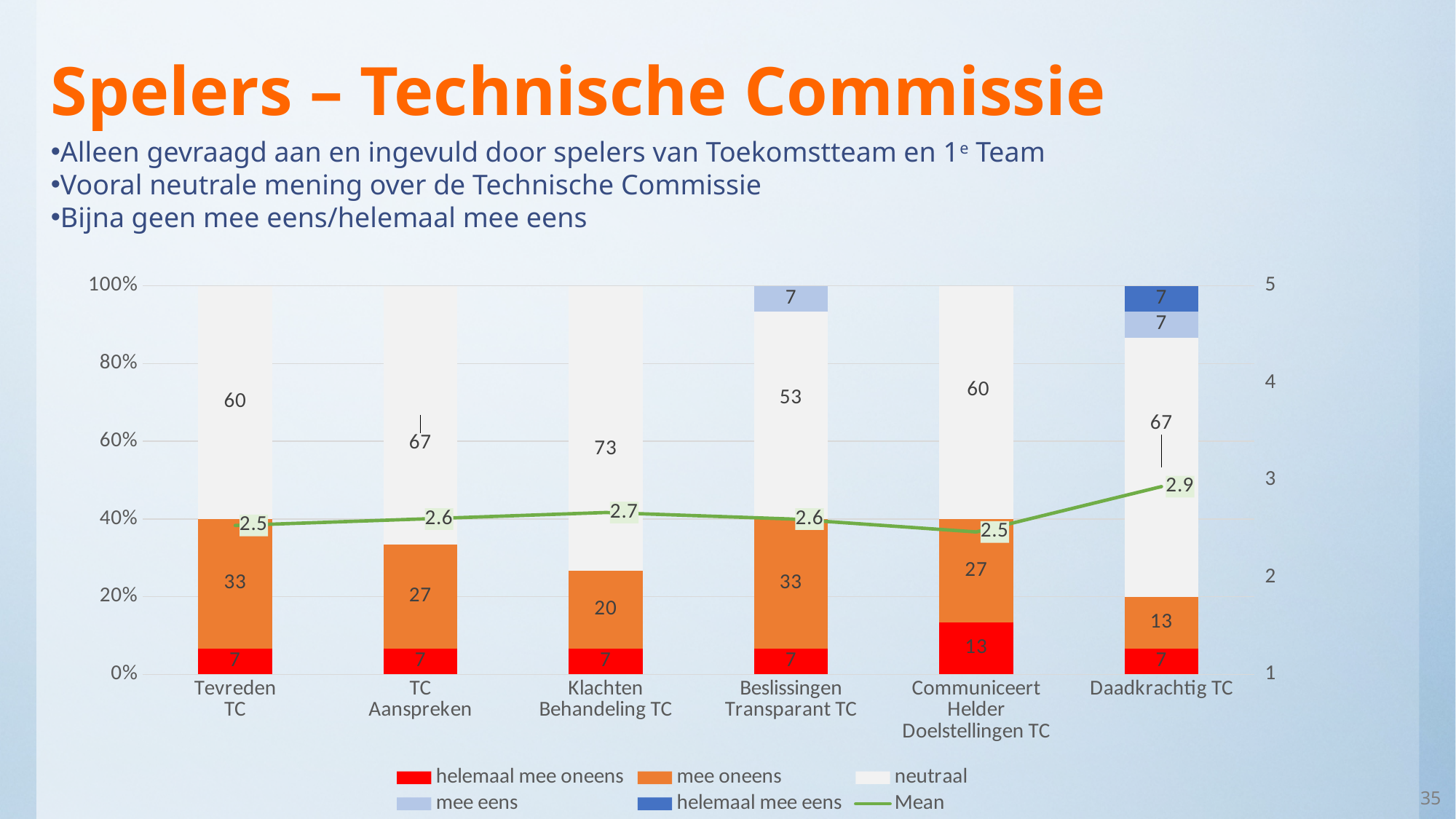
What is the 'helemaal mee oneens' value for Communiceert Helder Doelstellingen TC? 13 What is the 'neutraal' value for Klachten Behandeling TC? 73 How many entries does the legend list? 6 Which category has the lowest 'mee oneens' value? Daadkrachtig TC Which legend entry is shown in red? helemaal mee oneens What is the Mean value for Daadkrachtig TC? 2.9 What is the 'mee oneens' value for Daadkrachtig TC? 13 What is the difference between the 'neutraal' values for Klachten Behandeling TC and Beslissingen Transparant TC? 20 How many categories are shown on the x axis? 6 Which is larger: the 'mee oneens' value for Tevreden TC or for TC Aanspreken? Tevreden TC What kind of chart is shown on the slide? Stacked bar chart with a line Which category has the highest Mean value? Daadkrachtig TC